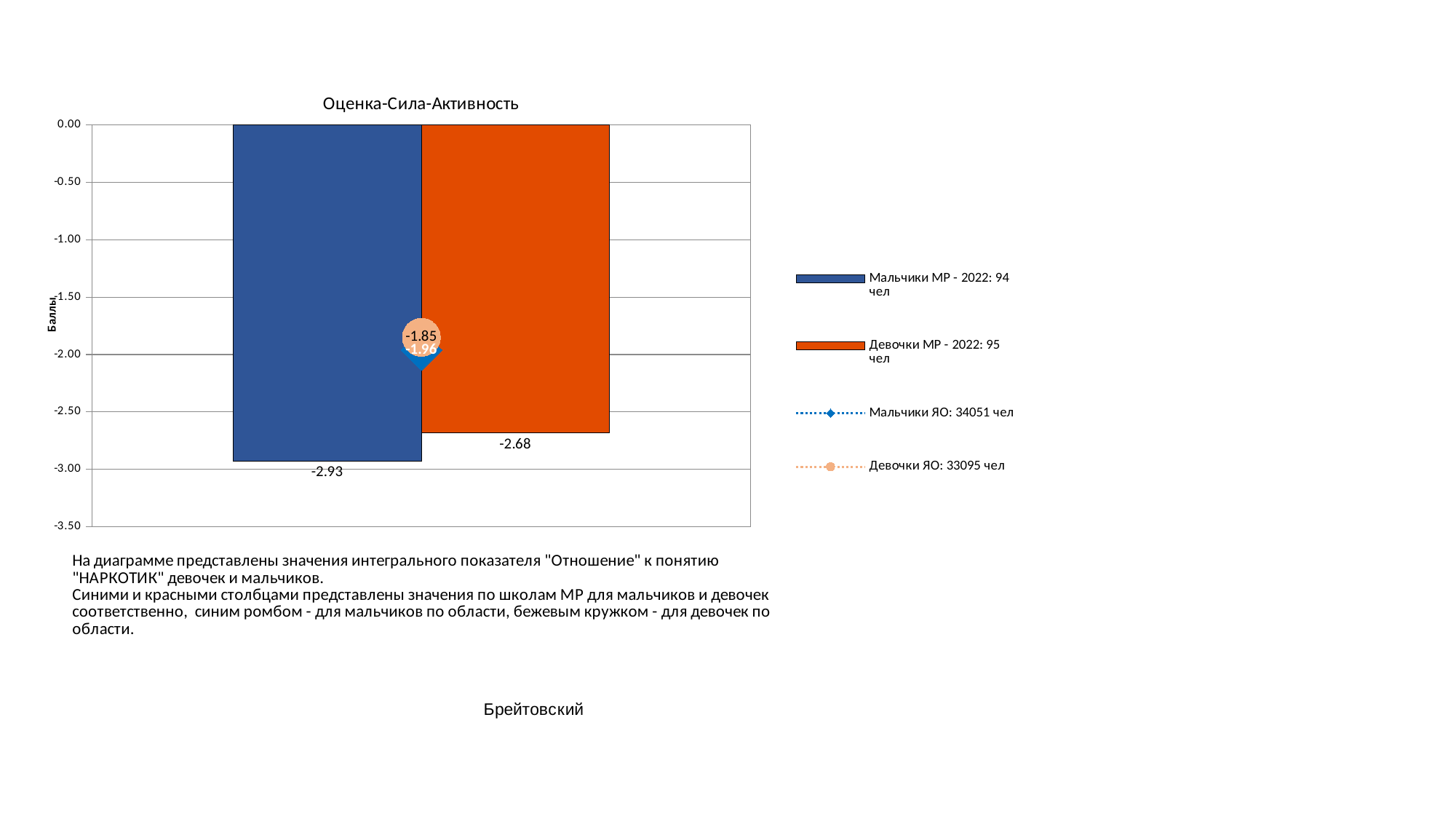
What value is shown for the Девочки ЯО: 33095 чел marker? -1.85 What type of chart is shown on the slide? bar chart What is the difference between the Девочки МР bar (-2.68) and the Мальчики МР bar (-2.93)? 0.25 Which is larger, the value for Девочки ЯО or the value for Мальчики ЯО? Девочки ЯО What is the title of the chart? Оценка-Сила-Активность What is the label of the vertical axis? Баллы What is the value of the bar for Мальчики МР - 2022: 94 чел? -2.93 What value is shown for the Мальчики ЯО: 34051 чел marker? -1.96 What is the value of the bar for Девочки МР - 2022: 95 чел? -2.68 Is the value for Мальчики МР greater or less than -2.50? less How many series does the legend list? 4 Which of the two bars has the lower value, Мальчики МР or Девочки МР? Мальчики МР